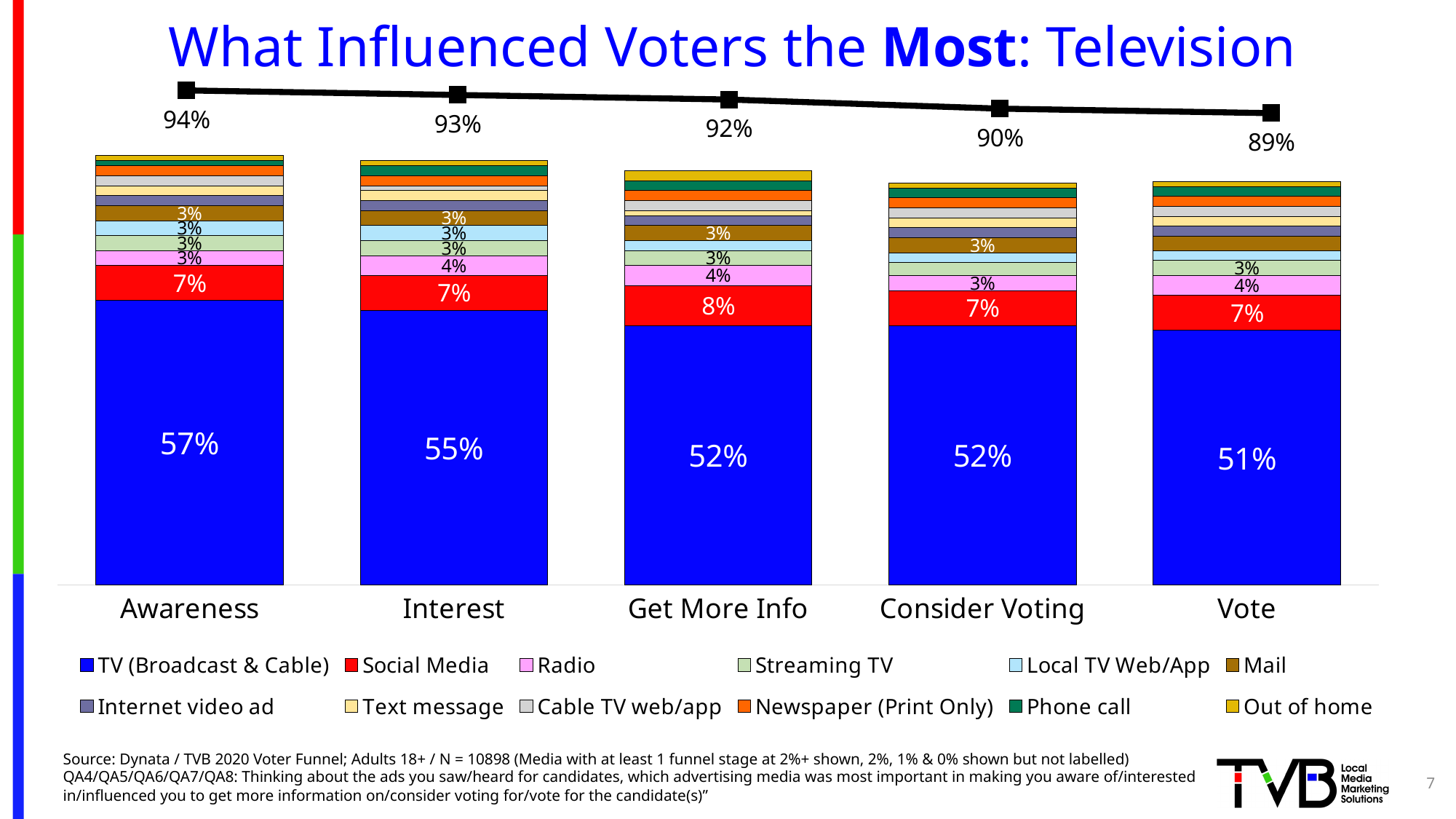
At which funnel stage is the line total lowest? Vote What total percentage does the line show above the Consider Voting bar? 90% What is the TV (Broadcast & Cable) value for the Vote stage? 51% What is the difference between the TV (Broadcast & Cable) values for Awareness and Vote? 6 percentage points What is the Radio value at the Interest stage? 4% What percentage of voters said TV (Broadcast & Cable) influenced them the most at the Awareness stage? 57% What is the Social Media value at the Get More Info stage? 8% Which is larger: the Social Media value at Get More Info or at Consider Voting? Get More Info How many series does the legend list? 12 At which funnel stage is the TV (Broadcast & Cable) share highest? Awareness How many funnel stages are shown on the x axis? 5 Do the line totals above the bars rise or fall from Awareness to Vote? fall